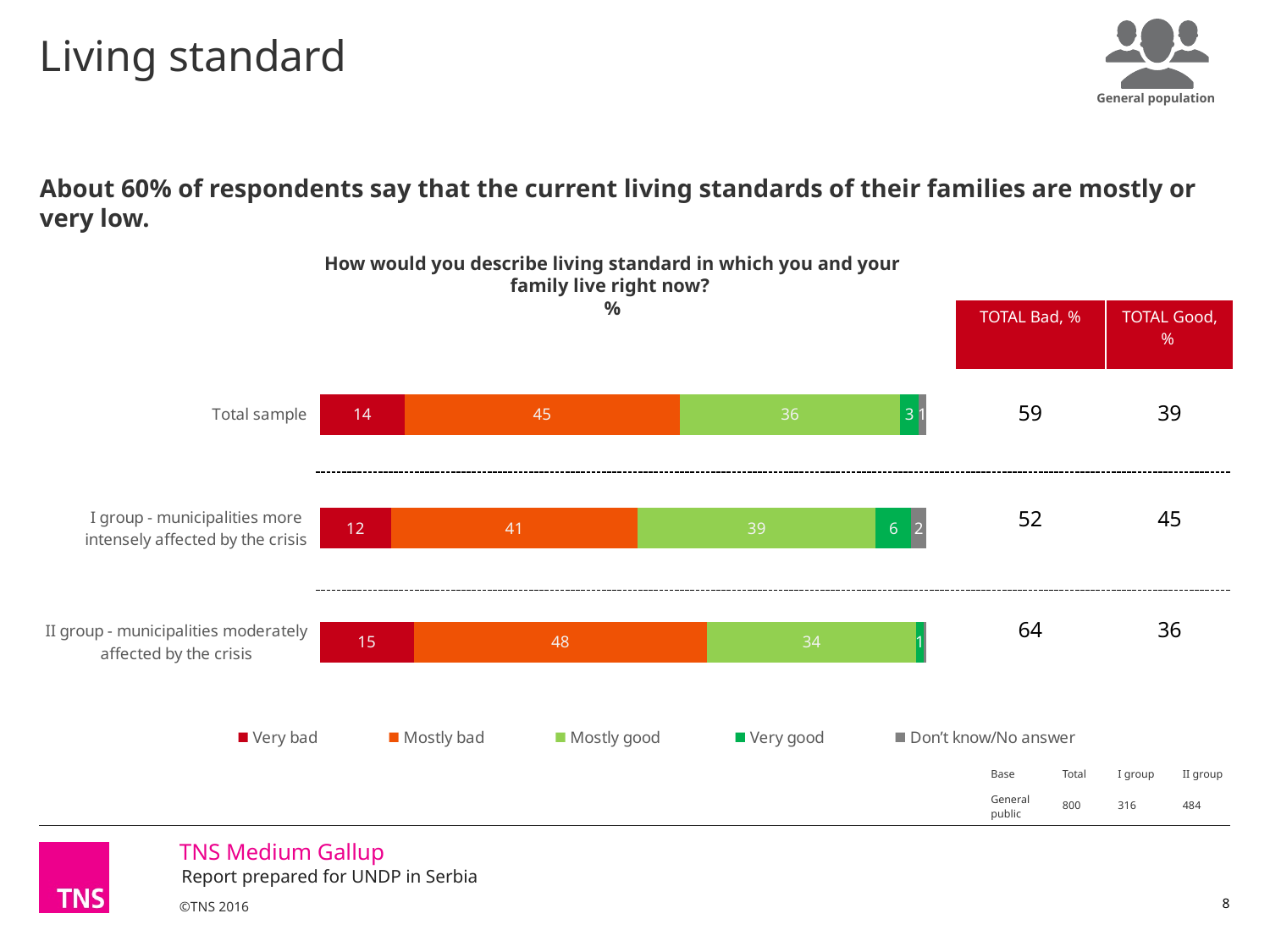
Which group has the highest 'Mostly bad' value? II group - municipalities moderately affected by the crisis What is the 'Very good' value for I group - municipalities more intensely affected by the crisis? 6 What is the 'Mostly good' value for I group - municipalities more intensely affected by the crisis? 39 What is the 'Very bad' value for II group - municipalities moderately affected by the crisis? 15 What is the TOTAL Bad, % value shown for II group - municipalities moderately affected by the crisis? 64 How many categories (groups) are plotted in the chart? 3 Is the 'Mostly good' value larger for the Total sample or for II group? Total sample What is the difference between the 'Mostly bad' values for II group and I group? 7 What is the 'Mostly bad' value for the Total sample? 45 What type of chart is shown on the slide? stacked bar chart How many series does the legend list? 5 Which group has the lowest 'Very bad' value? I group - municipalities more intensely affected by the crisis